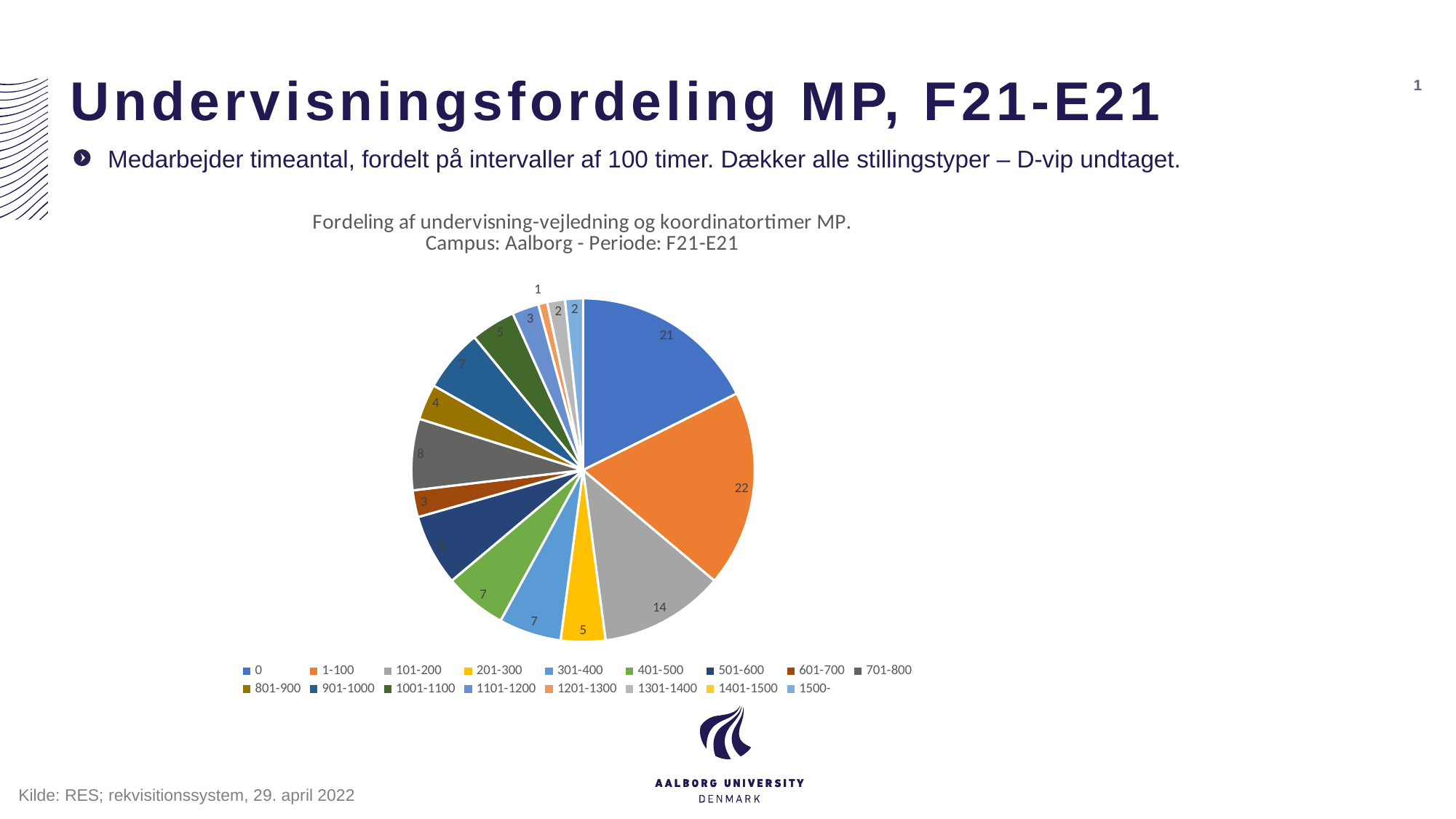
What is the value for the 801-900 category? 4 Which category has the smallest slice? 1201-1300 How many entries does the legend list? 17 What is the difference between the values for 0 and 101-200? 7 What is the difference between the values for 1-100 and 0? 1 Which is larger, the value for 101-200 or the value for 201-300? 101-200 Which category has the largest slice? 1-100 What is the value for the 101-200 category? 14 What kind of chart is shown on the slide? pie chart What is the value for the 1-100 category? 22 What is the value for the 201-300 category? 5 What is the value for the 0 category? 21